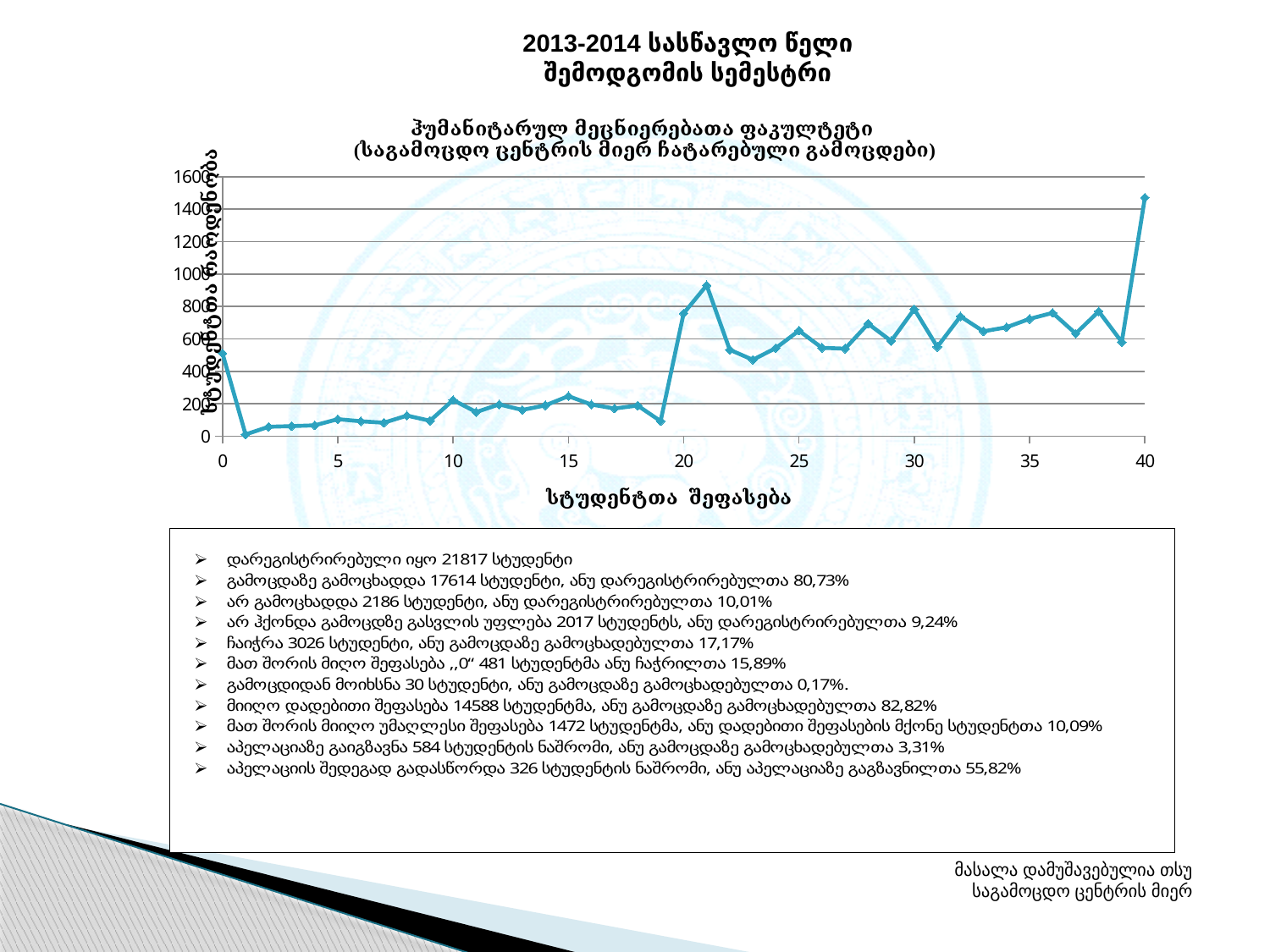
Is the value at x = 23 greater or less than 600? less Which has the larger value, x = 10 or x = 20? x = 20 What kind of chart is shown on the slide? line chart What is the label of the x axis? სტუდენტთა შეფასება Between x = 19 and x = 21, do the values rise or fall? rise What is the label of the y axis? სტუდენტთა რაოდენობა Is the value at x = 40 greater or less than 1200? greater At which x-axis value does the line reach its lowest point? 1 At which x-axis value does the line reach its highest point? 40 Is the value at x = 1 greater or less than 200? less Which has the larger value, x = 21 or x = 22? x = 21